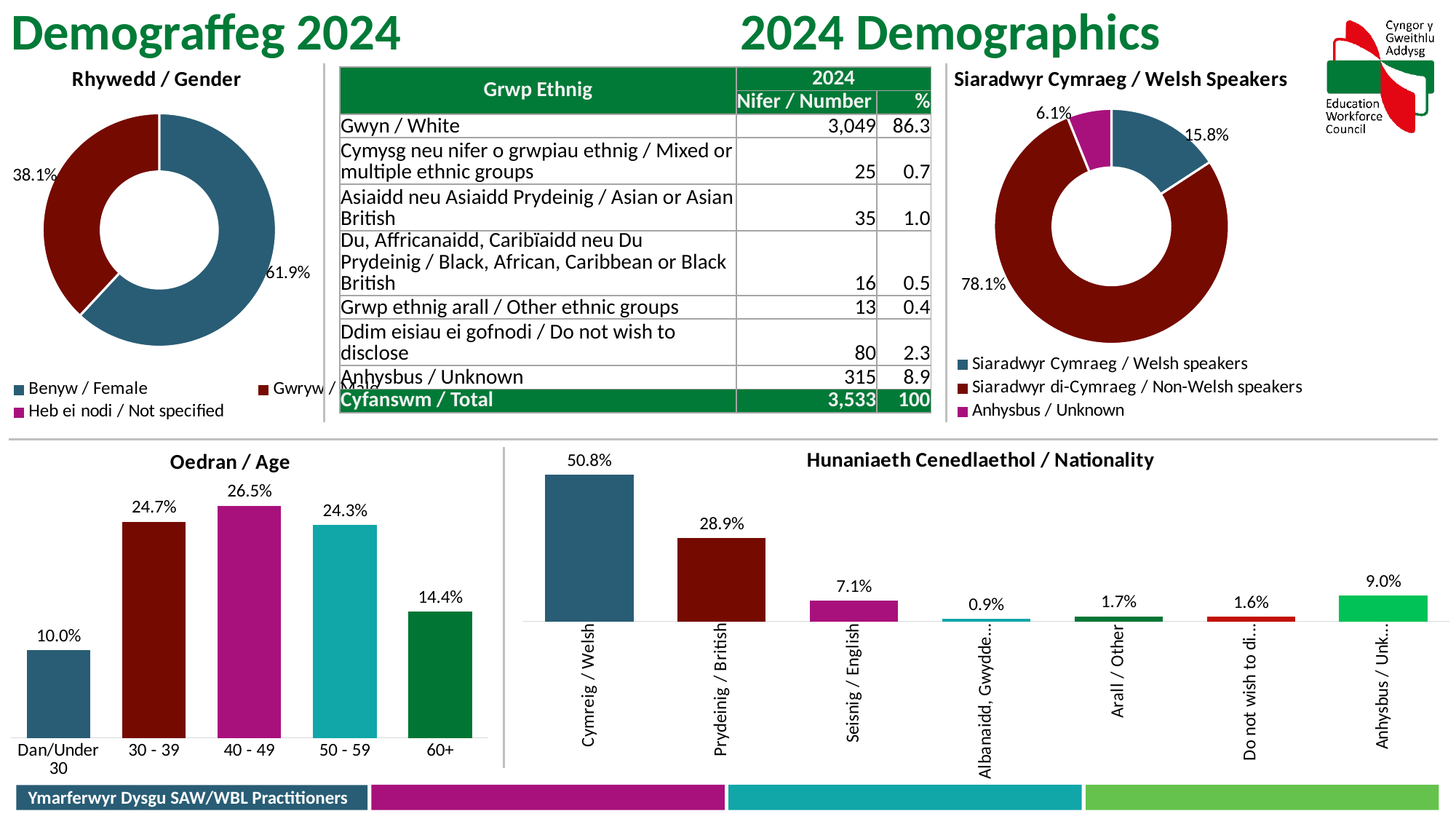
How many entries does the legend of the Siaradwyr Cymraeg / Welsh Speakers chart list? 3 In the Oedran / Age chart, which age group has the highest percentage? 40 - 49 In the Oedran / Age chart, which age group has the lowest percentage? Dan/Under 30 In the Siaradwyr Cymraeg / Welsh Speakers chart, what percentage is shown for Anhysbus / Unknown? 6.1% What kind of chart is the Rhywedd / Gender chart? Donut (pie) chart In the Hunaniaeth Cenedlaethol / Nationality chart, what percentage is shown for Prydeinig / British? 28.9% In the Siaradwyr Cymraeg / Welsh Speakers chart, what percentage is shown for Siaradwyr di-Cymraeg / Non-Welsh speakers? 78.1% In the Oedran / Age chart, what is the difference between the 30 - 39 and 60+ percentages? 10.3% In the Rhywedd / Gender chart, what percentage is shown for Benyw / Female? 61.9% In the Hunaniaeth Cenedlaethol / Nationality chart, which is larger: Seisnig / English or Arall / Other? Seisnig / English In the Rhywedd / Gender chart, what percentage is shown for Gwryw / Male? 38.1% How many age groups are shown in the Oedran / Age chart? 5